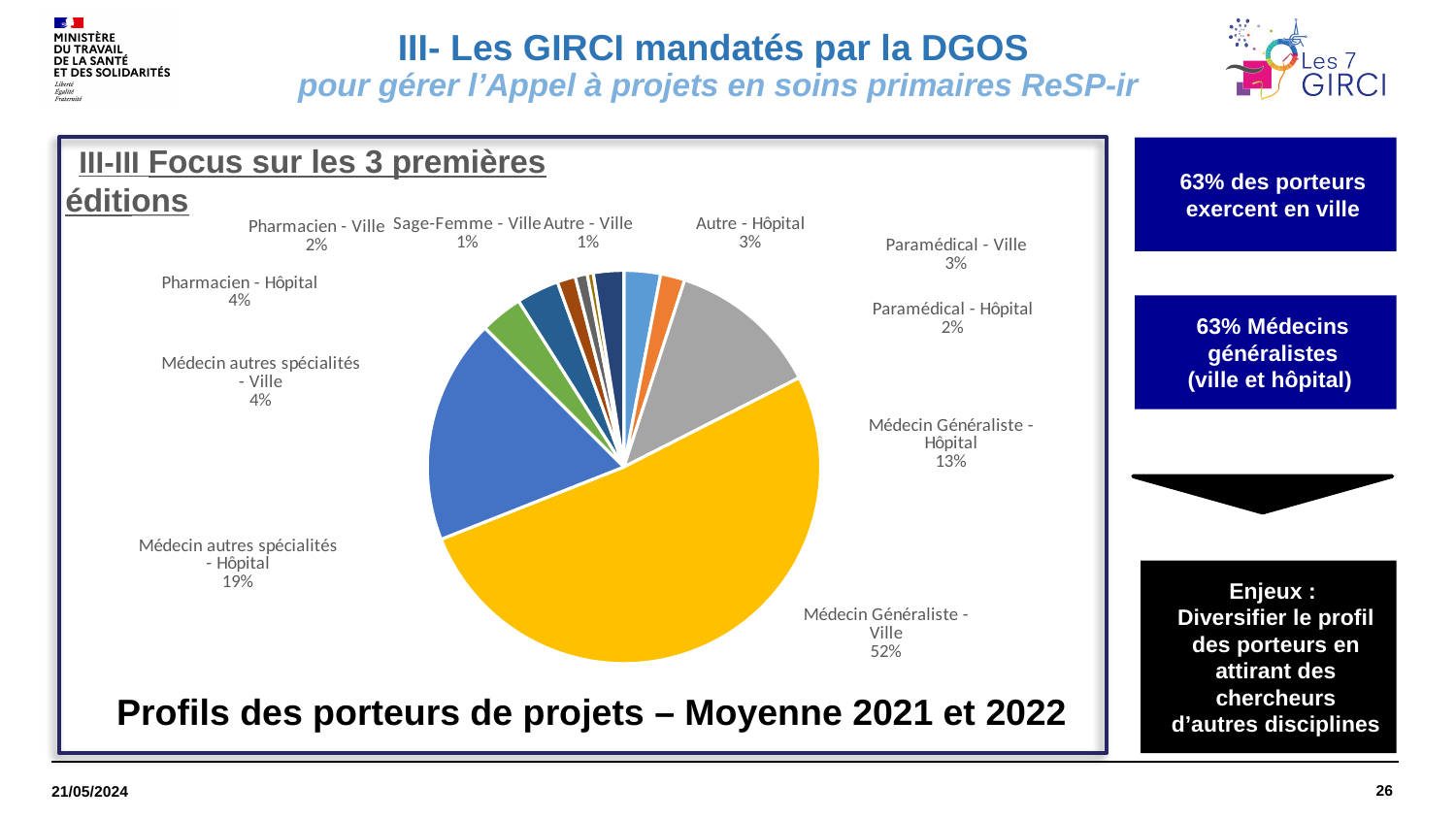
What share of the pie is Pharmacien - Hôpital? 4% What share of the pie is Médecin Généraliste - Ville? 52% What share of the pie is Médecin Généraliste - Hôpital? 13% Which is larger: Médecin autres spécialités - Hôpital or Médecin Généraliste - Hôpital? Médecin autres spécialités - Hôpital What is the combined share of Médecin Généraliste - Ville and Médecin Généraliste - Hôpital? 65% What is the title of the pie chart? Profils des porteurs de projets – Moyenne 2021 et 2022 How many categories are shown in the pie chart? 11 What kind of chart is shown on the slide? pie chart What is the difference in percentage points between Médecin Généraliste - Ville and Médecin autres spécialités - Hôpital? 33 Which category has the largest slice of the pie? Médecin Généraliste - Ville